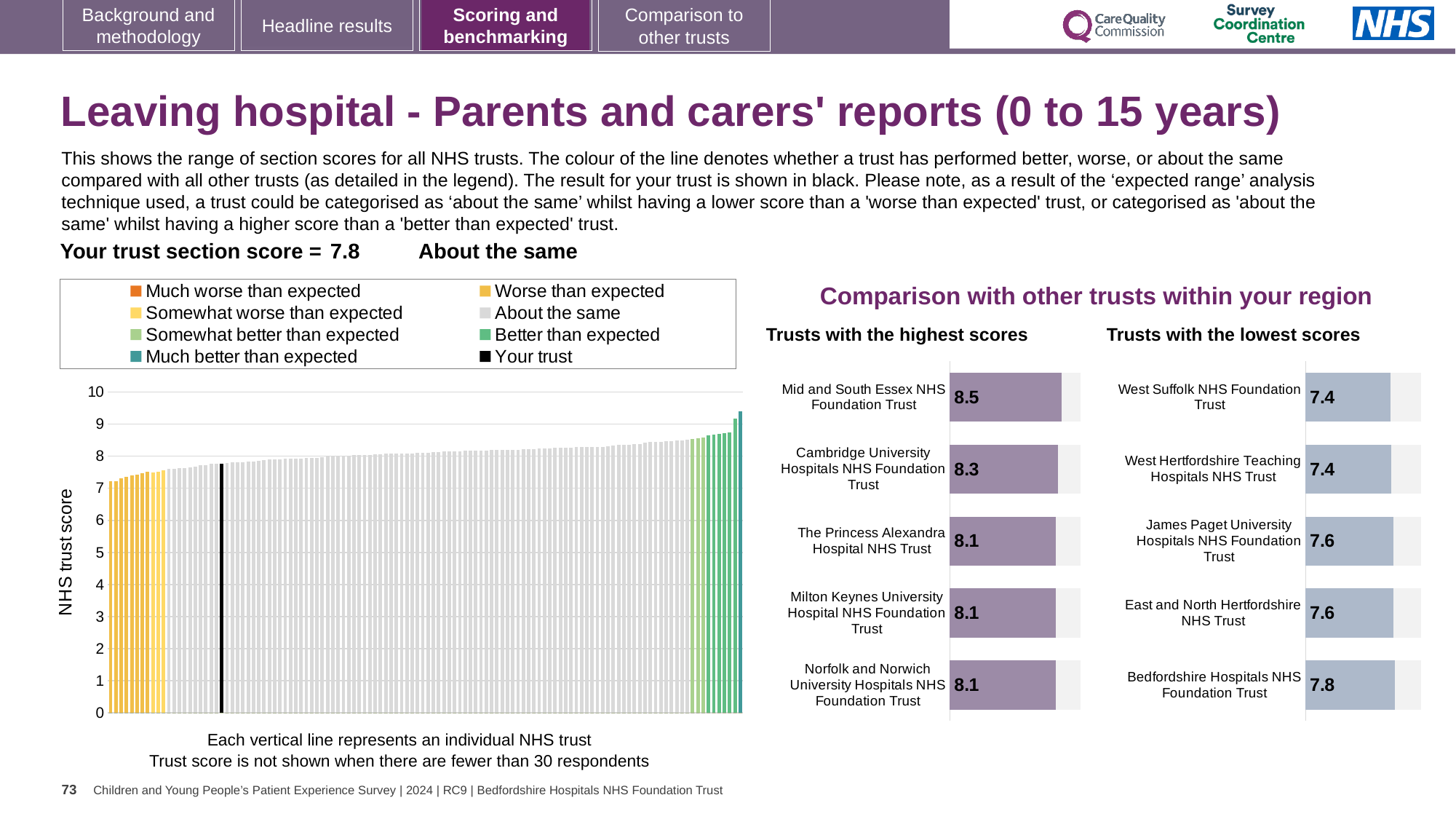
In the 'Trusts with the lowest scores' chart, which has the larger score: Bedfordshire Hospitals NHS Foundation Trust or West Hertfordshire Teaching Hospitals NHS Trust? Bedfordshire Hospitals NHS Foundation Trust What kind of chart is the large chart on the left showing NHS trust scores? Bar chart In the 'Trusts with the highest scores' chart, what is the score for Cambridge University Hospitals NHS Foundation Trust? 8.3 In the 'Trusts with the highest scores' chart, how many trusts are listed? 5 In the 'Trusts with the highest scores' chart, what is the difference between the scores of Mid and South Essex NHS Foundation Trust and Cambridge University Hospitals NHS Foundation Trust? 0.2 In the 'Trusts with the lowest scores' chart, what is the score for James Paget University Hospitals NHS Foundation Trust? 7.6 In the 'Trusts with the highest scores' chart, which trust has the highest score? Mid and South Essex NHS Foundation Trust In the 'Trusts with the lowest scores' chart, which trust has the highest score? Bedfordshire Hospitals NHS Foundation Trust In the 'Trusts with the lowest scores' chart, what is the difference between the scores of Bedfordshire Hospitals NHS Foundation Trust and West Suffolk NHS Foundation Trust? 0.4 In the 'Trusts with the highest scores' chart, what is the score for Mid and South Essex NHS Foundation Trust? 8.5 In the 'Trusts with the lowest scores' chart, what is the score for Bedfordshire Hospitals NHS Foundation Trust? 7.8 In the large chart on the left, do the NHS trust scores rise or fall from left to right along the x axis? Rise